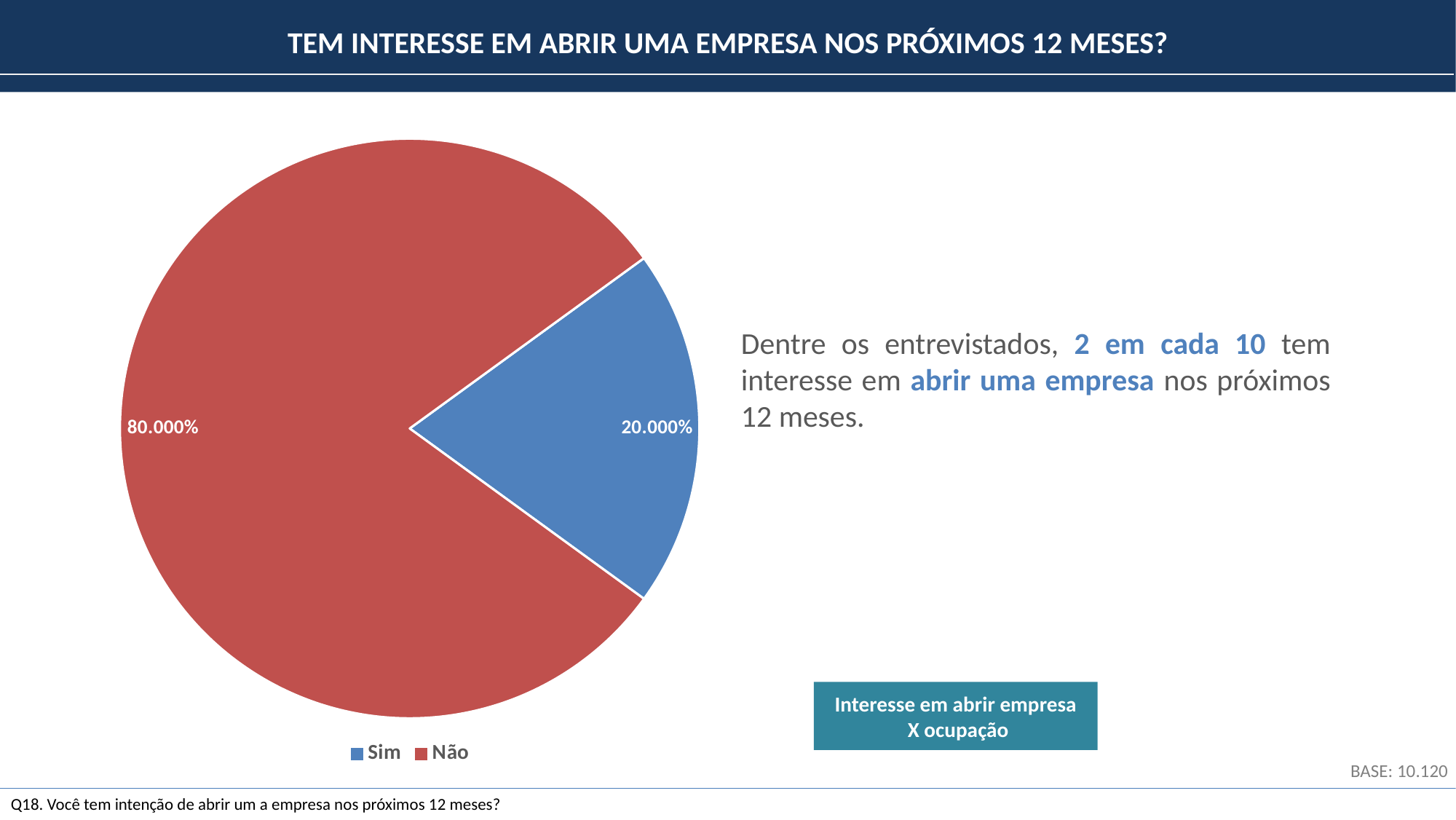
How many entries does the legend of the pie chart list? 2 Which category has the smallest slice in the pie chart? Sim What is the value for "Não" in the pie chart? 80.000% What share of the pie does the "Sim" slice represent? 20.000% How many categories does the pie chart show? 2 Which category has the largest slice in the pie chart? Não Which is larger in the pie chart, "Sim" or "Não"? Não What type of chart is shown on the slide? Pie chart What colour is the "Não" slice in the pie chart? Red What is the value for "Sim" in the pie chart? 20.000% What is the difference between the "Não" and "Sim" values in the pie chart? 60.000% What is the title of the slide containing the pie chart? TEM INTERESSE EM ABRIR UMA EMPRESA NOS PRÓXIMOS 12 MESES?